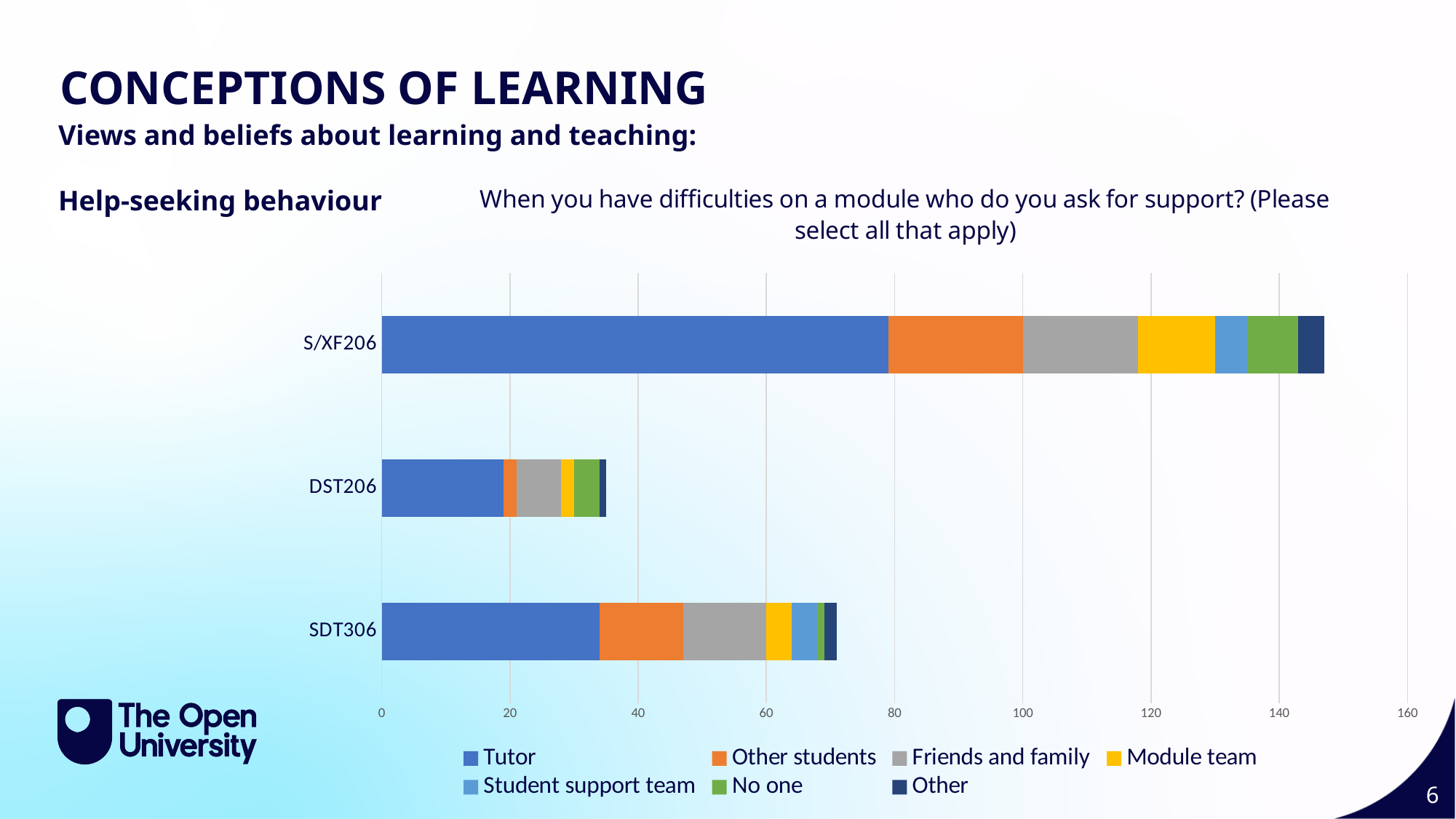
Which module has the longest total bar? S/XF206 Which has the larger Tutor segment, S/XF206 or SDT306? S/XF206 Is the total bar length for S/XF206 greater or less than 140? greater How many series does the chart legend list? 7 Which has the longer total bar, DST206 or SDT306? SDT306 What kind of chart is shown on the slide? Stacked bar chart How many modules (categories) are plotted on the chart? 3 Which module has the shortest total bar? DST206 Is the total bar length for DST206 greater or less than 40? less Is the Tutor segment for SDT306 greater or less than 40? less Which series is shown in orange in the chart legend? Other students